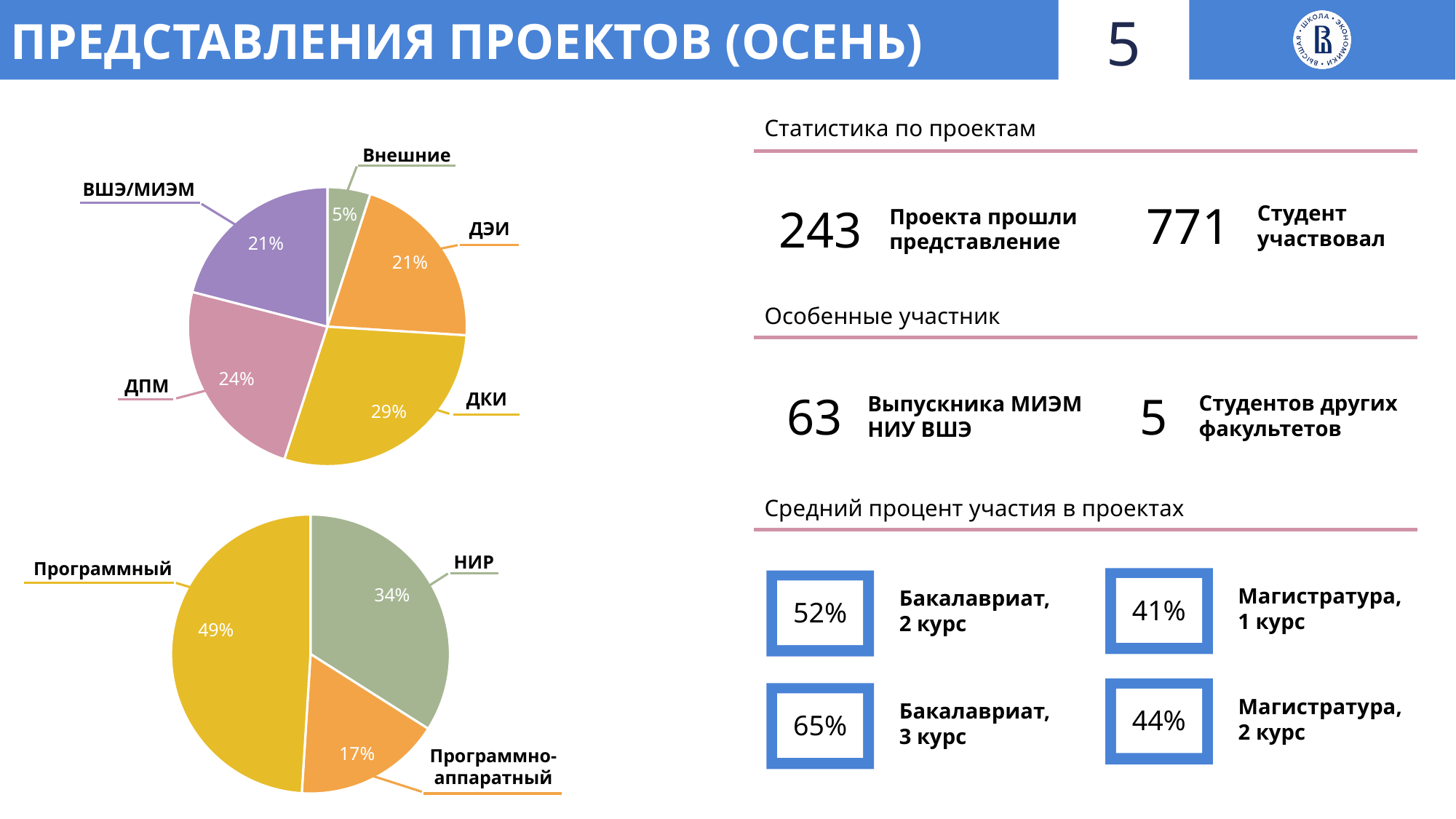
In the top pie chart, what is the difference between the shares of ДКИ and ДПМ? 5% In the bottom pie chart, what share does Программно-аппаратный have? 17% In the bottom pie chart, what share does НИР have? 34% In the top pie chart, what share does ДКИ have? 29% In the top pie chart, which category has the smallest share? Внешние What type of chart is the bottom chart on the slide? Pie chart In the top pie chart, which category has the largest share? ДКИ In the bottom pie chart, which category has the largest share? Программный In the bottom pie chart, what is the difference between the shares of Программный and НИР? 15% In the top pie chart, what share does Внешние have? 5% In the top pie chart, how many slices are there? 5 In the bottom pie chart, which is larger: НИР or Программно-аппаратный? НИР